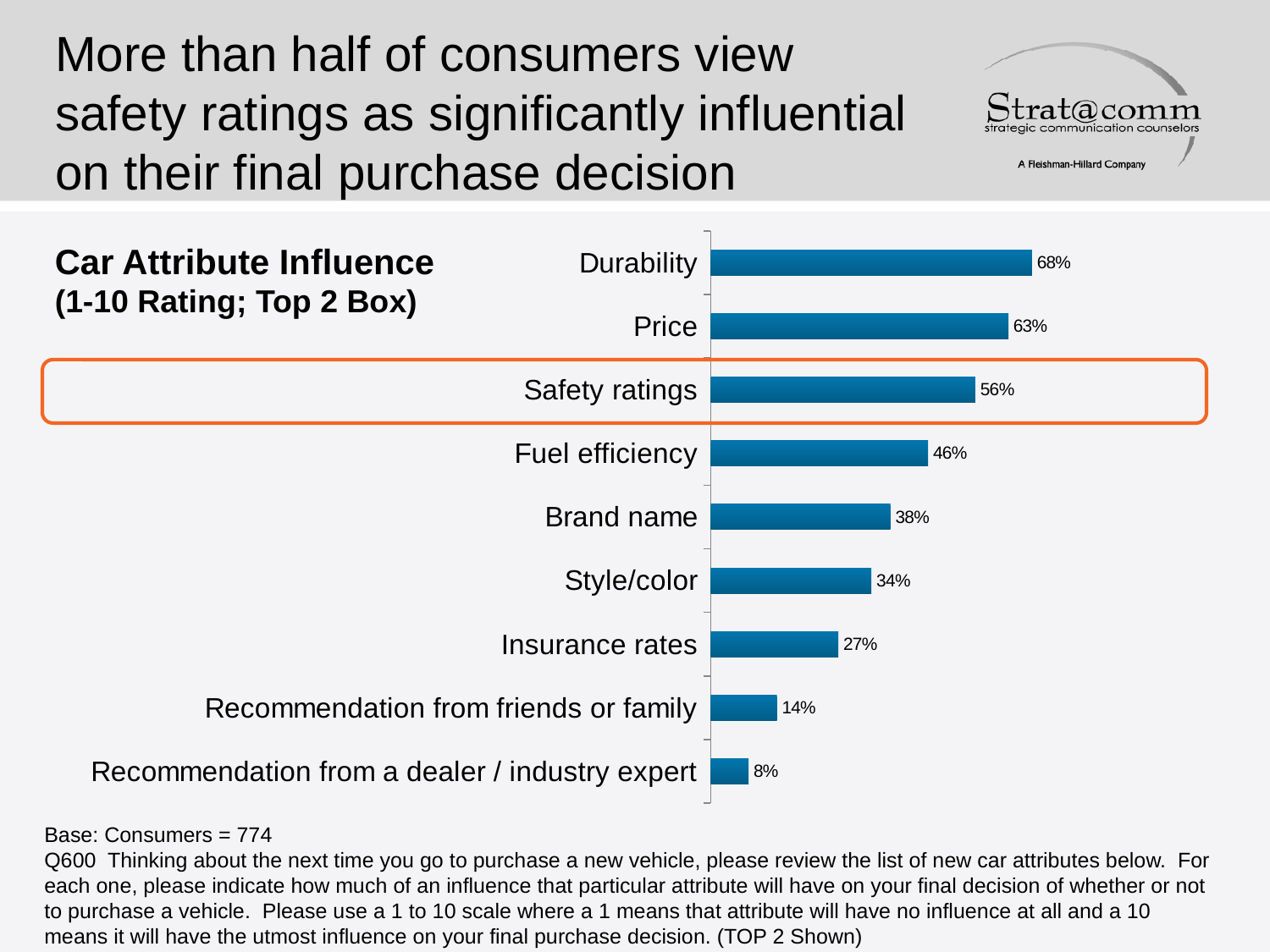
How many car attributes are shown in the chart? 9 What is the title of the chart? Car Attribute Influence (1-10 Rating; Top 2 Box) What percentage of consumers rated Safety ratings in the top 2 box for influence on their purchase decision? 56% What is the value shown for Recommendation from friends or family? 14% Which car attribute has the lowest top 2 box percentage? Recommendation from a dealer / industry expert What type of chart is used on this slide? Bar chart What is the value shown for Fuel efficiency? 46% What is the difference in percentage points between Brand name and Style/color? 4 What is the difference in percentage points between Durability and Price? 5 Which has a higher value, Insurance rates or Style/color? Style/color Which car attribute has the highest top 2 box percentage? Durability Which bar on the chart is highlighted with an orange box? Safety ratings